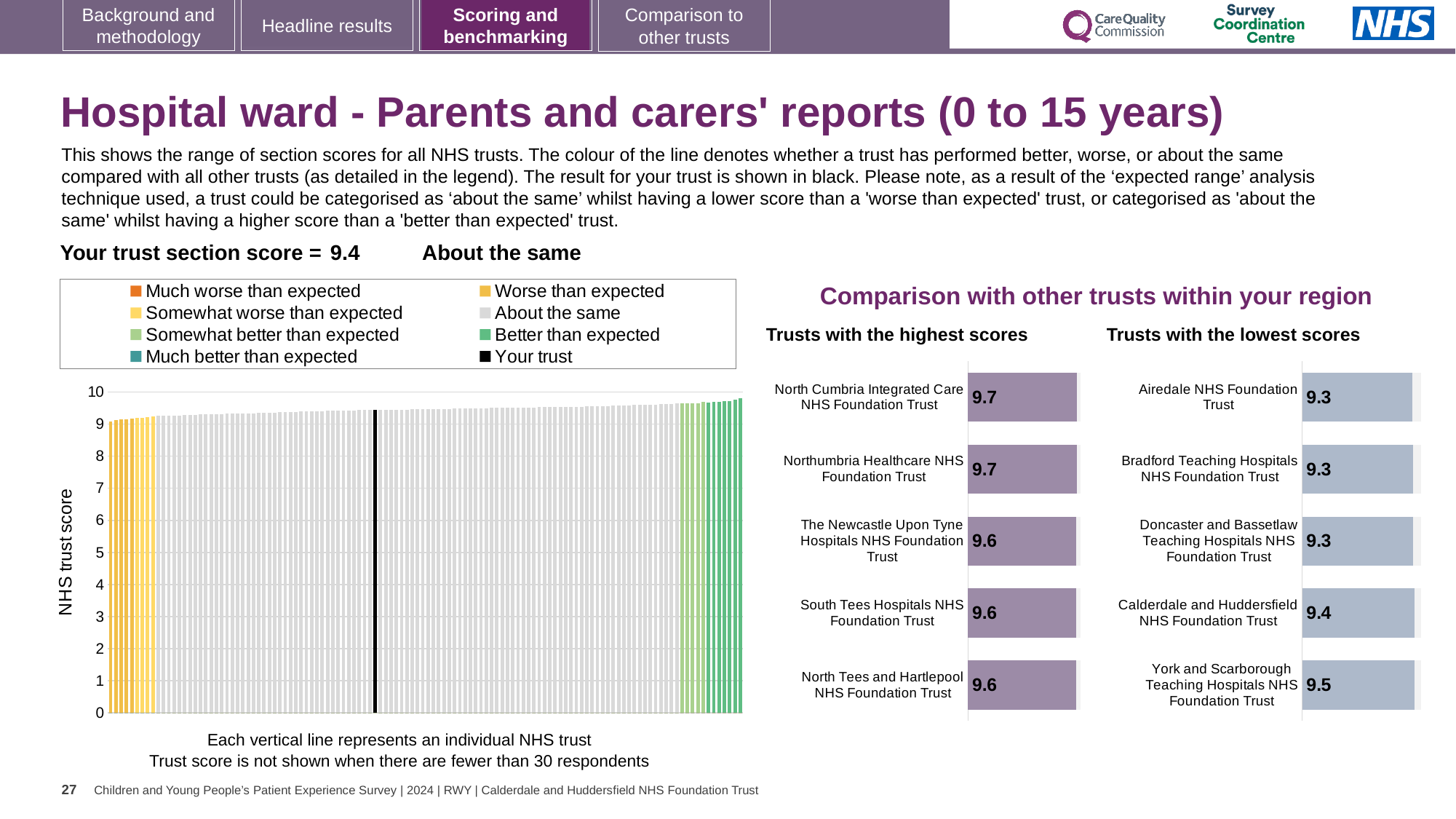
How many trusts are shown in the 'Trusts with the lowest scores' chart? 5 How many entries does the legend of the large chart on the left list? 8 What kind of chart is the large chart on the left showing the range of section scores for all NHS trusts? Bar chart In the large chart on the left, is the value for your trust (the black line) greater or less than 9? greater How many trusts are shown in the 'Trusts with the highest scores' chart? 5 In the 'Trusts with the highest scores' chart, what is the score for North Cumbria Integrated Care NHS Foundation Trust? 9.7 In the 'Trusts with the lowest scores' chart, what is the difference between the scores of York and Scarborough Teaching Hospitals NHS Foundation Trust and Airedale NHS Foundation Trust? 0.2 In the 'Trusts with the highest scores' chart, what is the difference between the scores of North Cumbria Integrated Care NHS Foundation Trust and North Tees and Hartlepool NHS Foundation Trust? 0.1 In the 'Trusts with the highest scores' chart, what is the score for South Tees Hospitals NHS Foundation Trust? 9.6 In the 'Trusts with the highest scores' chart, which has the larger score: Northumbria Healthcare NHS Foundation Trust or The Newcastle Upon Tyne Hospitals NHS Foundation Trust? Northumbria Healthcare NHS Foundation Trust In the 'Trusts with the lowest scores' chart, which trust has the highest score? York and Scarborough Teaching Hospitals NHS Foundation Trust In the 'Trusts with the lowest scores' chart, what is the score for Calderdale and Huddersfield NHS Foundation Trust? 9.4